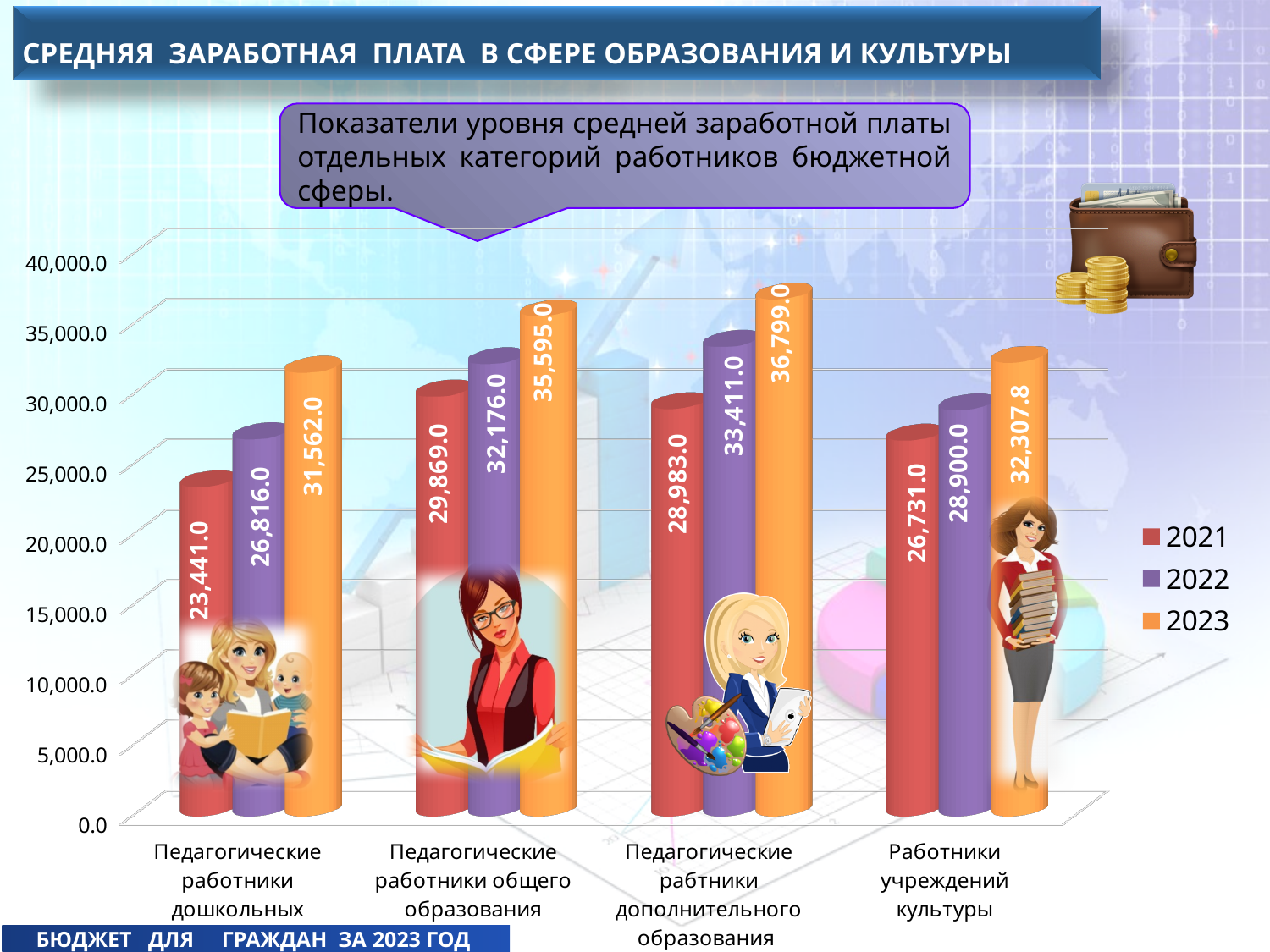
What kind of chart is shown on the slide? Bar chart For Работники учреждений культуры, do the values rise or fall from 2021 to 2023? Rise Which category has the highest 2023 value? Педагогические рабтники дополнительного образования Which is larger: the 2022 value for Педагогические работники общего образования or the 2022 value for Педагогические рабтники дополнительного образования? Педагогические рабтники дополнительного образования How many categories are shown on the x axis? 4 What is the 2021 value for Работники учреждений культуры? 26,731.0 Which category has the lowest 2021 value? Педагогические работники дошкольных What is the difference between the 2023 and 2021 values for Педагогические работники дошкольных? 8,121.0 How many series does the legend list? 3 What is the difference between the 2023 and 2022 values for Работники учреждений культуры? 3,407.8 What is the 2022 value for Педагогические работники дошкольных? 26,816.0 What is the 2023 value for Педагогические работники общего образования? 35,595.0